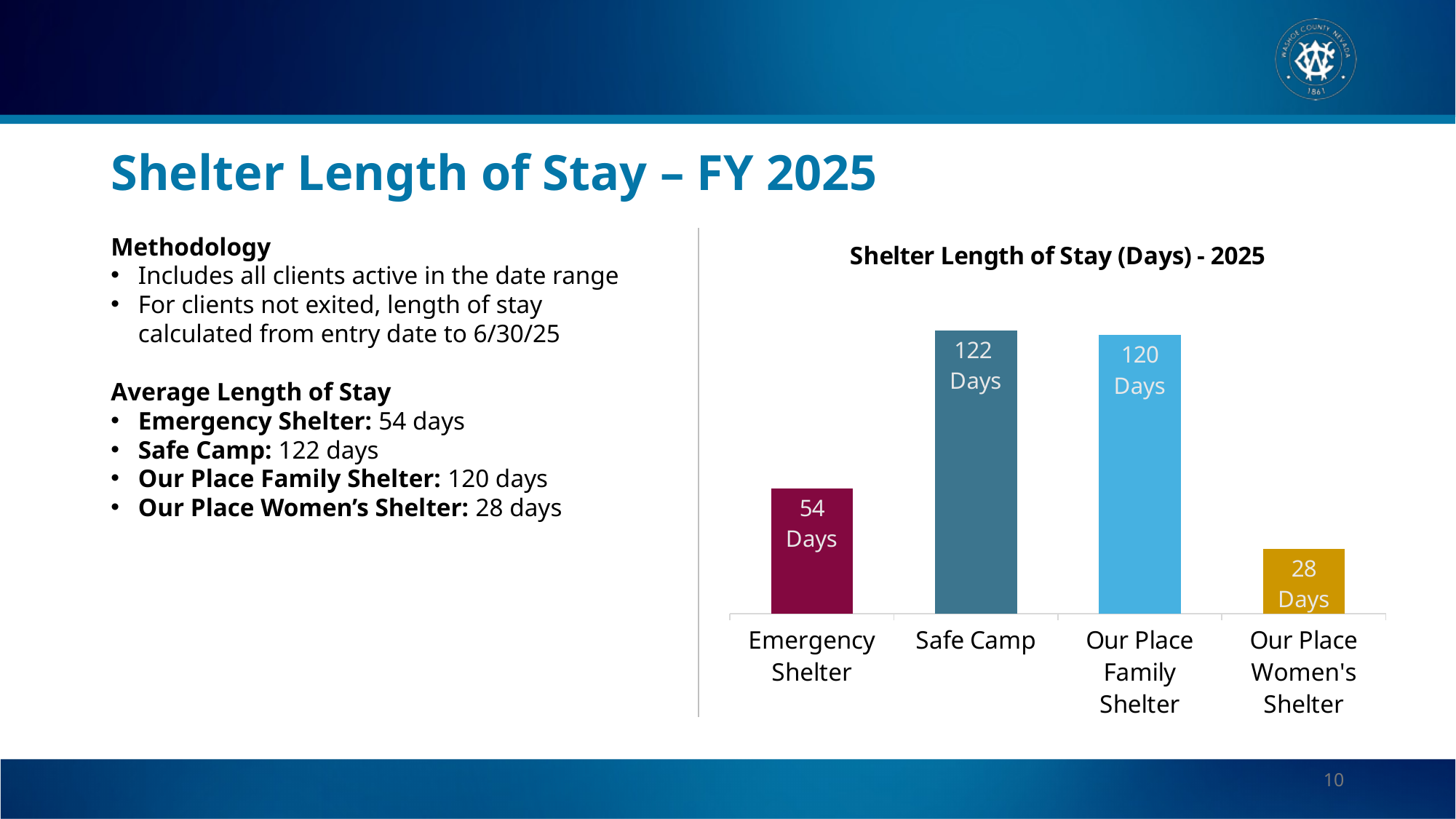
What is the difference in days between Safe Camp and Emergency Shelter? 68 Days Which has a longer length of stay, Emergency Shelter or Our Place Family Shelter? Our Place Family Shelter Which shelter has the shortest length of stay? Our Place Women's Shelter What is the length of stay for Emergency Shelter? 54 Days How many shelters are shown in the chart? 4 Which shelter has the longest length of stay? Safe Camp What type of chart is shown on the slide? Bar chart What is the title of the chart? Shelter Length of Stay (Days) - 2025 What is the length of stay for Safe Camp? 122 Days What is the length of stay for Our Place Family Shelter? 120 Days What is the length of stay for Our Place Women's Shelter? 28 Days What is the difference in days between Emergency Shelter and Our Place Women's Shelter? 26 Days